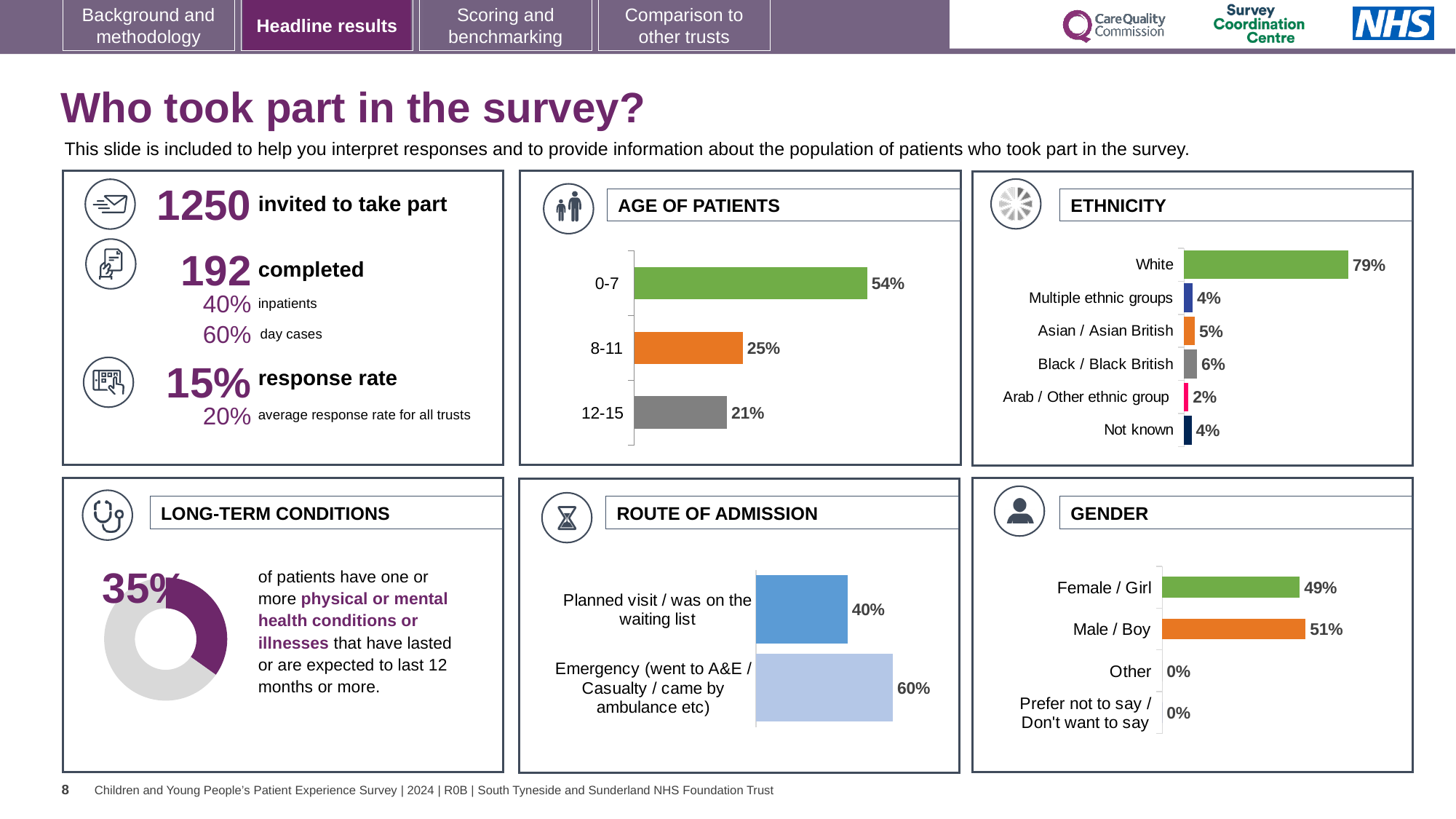
In the ETHNICITY chart, which category has the lowest percentage? Arab / Other ethnic group In the AGE OF PATIENTS chart, what is the difference between the 0-7 and 8-11 percentages? 29% In the ROUTE OF ADMISSION chart, what is the difference between the Emergency and Planned visit percentages? 20% What type of chart is used in the LONG-TERM CONDITIONS panel? Doughnut chart In the GENDER chart, how many gender categories are listed? 4 In the ROUTE OF ADMISSION chart, what percentage of patients came via Emergency (went to A&E / Casualty / came by ambulance etc)? 60% In the ETHNICITY chart, how many ethnicity categories are shown? 6 In the ETHNICITY chart, what percentage of patients were White? 79% In the AGE OF PATIENTS chart, which age group has the lowest percentage? 12-15 In the GENDER chart, what percentage of patients were Male / Boy? 51% In the ETHNICITY chart, which is larger: Asian / Asian British or Black / Black British? Black / Black British In the AGE OF PATIENTS chart, what percentage of patients were aged 0-7? 54%